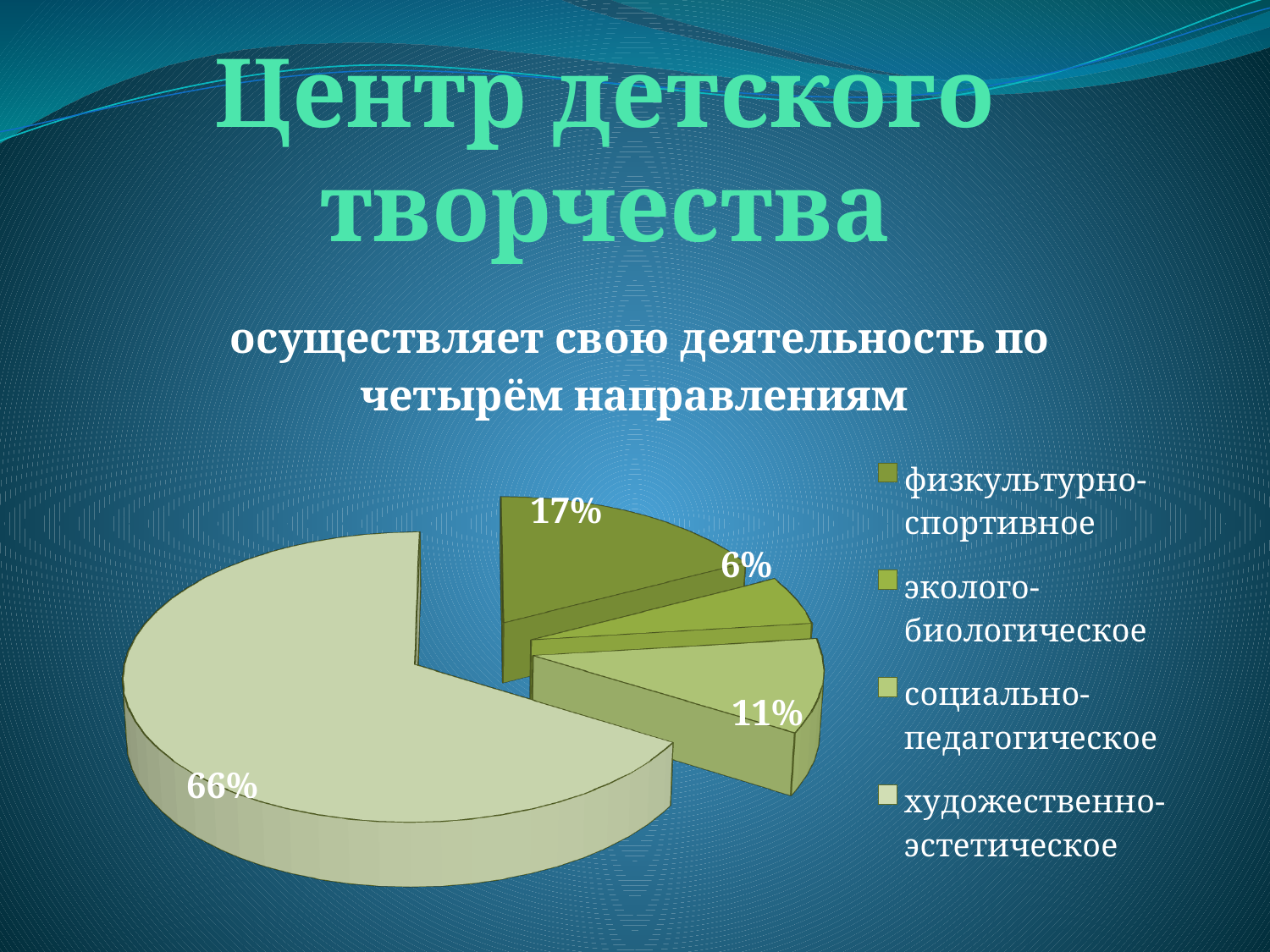
What is the difference in percentage points between художественно-эстетическое and физкультурно-спортивное? 49 How many slices does the pie chart have? 4 Which category has the smallest slice of the pie? эколого-биологическое How many entries does the legend list? 4 What is the combined share of физкультурно-спортивное and социально-педагогическое? 28% What share of the pie does социально-педагогическое have? 11% What kind of chart is shown on the slide? pie chart What share of the pie does художественно-эстетическое have? 66% What share of the pie does физкультурно-спортивное have? 17% Which is larger, the slice for социально-педагогическое or the slice for эколого-биологическое? социально-педагогическое Which category has the largest slice of the pie? художественно-эстетическое What share of the pie does эколого-биологическое have? 6%